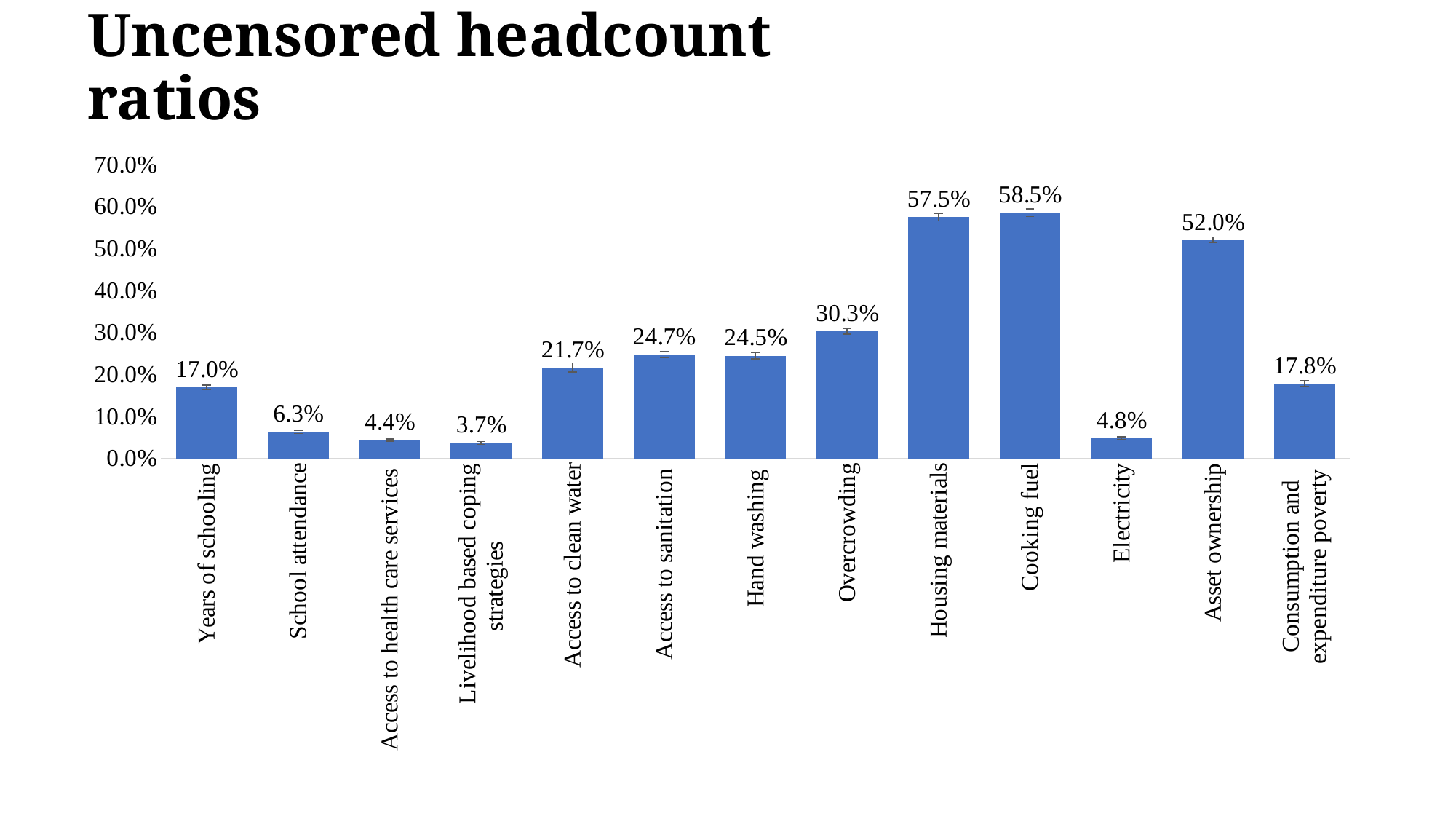
Which category has the highest uncensored headcount ratio? Cooking fuel What is the title of the chart? Uncensored headcount ratios What is the difference between the values for School attendance and Access to health care services? 1.9% How many categories are shown on the x axis? 13 Which is larger, the value for Overcrowding or the value for Access to sanitation? Overcrowding What is the value shown for Access to clean water? 21.7% Is the value for Asset ownership greater or less than 50.0%? greater What is the value shown for Electricity? 4.8% What is the uncensored headcount ratio for Cooking fuel? 58.5% What kind of chart is shown on the slide? Bar chart Which category has the lowest uncensored headcount ratio? Livelihood based coping strategies What is the difference between the values for Housing materials and Asset ownership? 5.5%